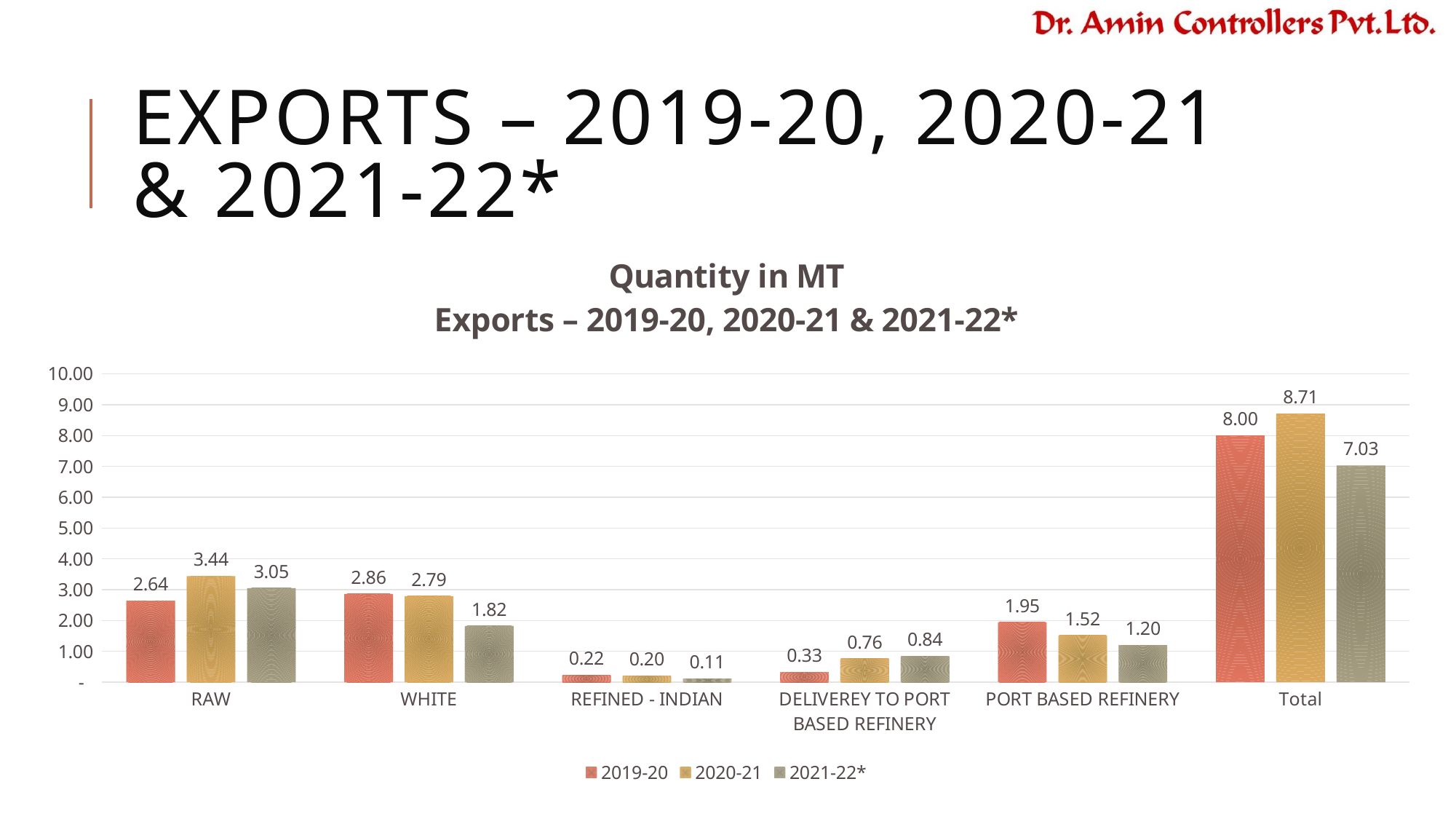
Which year has the highest Total value? 2020-21 What kind of chart is shown on the slide? Bar chart What is the value for WHITE in 2021-22*? 1.82 How many series does the legend list? 3 What is the value for RAW in 2020-21? 3.44 Which is larger for PORT BASED REFINERY: the 2019-20 value or the 2021-22* value? 2019-20 What is the difference between the Total values for 2020-21 and 2021-22*? 1.68 Do the values for WHITE rise or fall from 2019-20 to 2021-22*? Fall What is the Total value for 2019-20? 8.00 Which category has the lowest value in the 2021-22* series? REFINED - INDIAN How many categories are shown on the x axis? 6 What unit is the quantity measured in, according to the chart title? MT